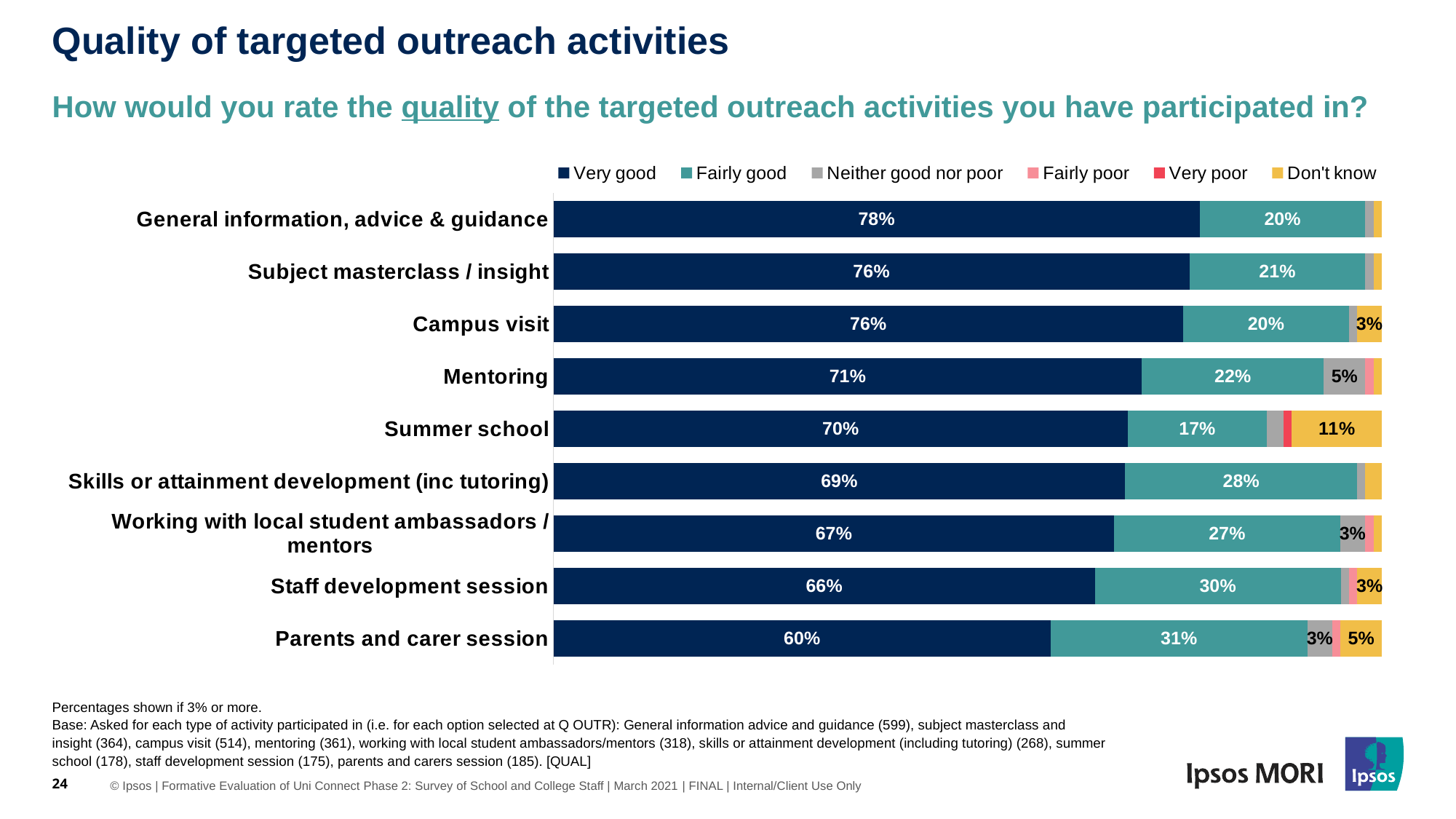
Which has a larger Fairly good percentage: Staff development session or Summer school? Staff development session What type of chart is shown on the slide? Stacked bar chart What is the Don't know percentage for Summer school? 11% What is the difference between the Very good percentages for General information, advice & guidance and Parents and carer session? 18 percentage points Which activity has the highest Very good percentage? General information, advice & guidance How many activities are shown in the chart? 9 What percentage rated the quality of General information, advice & guidance as Very good? 78% Which activity has the lowest Very good percentage? Parents and carer session How many rating categories does the legend list? 6 What percentage rated Mentoring as Neither good nor poor? 5% What percentage rated Parents and carer session as Fairly good? 31% Which legend entry is shown in yellow? Don't know